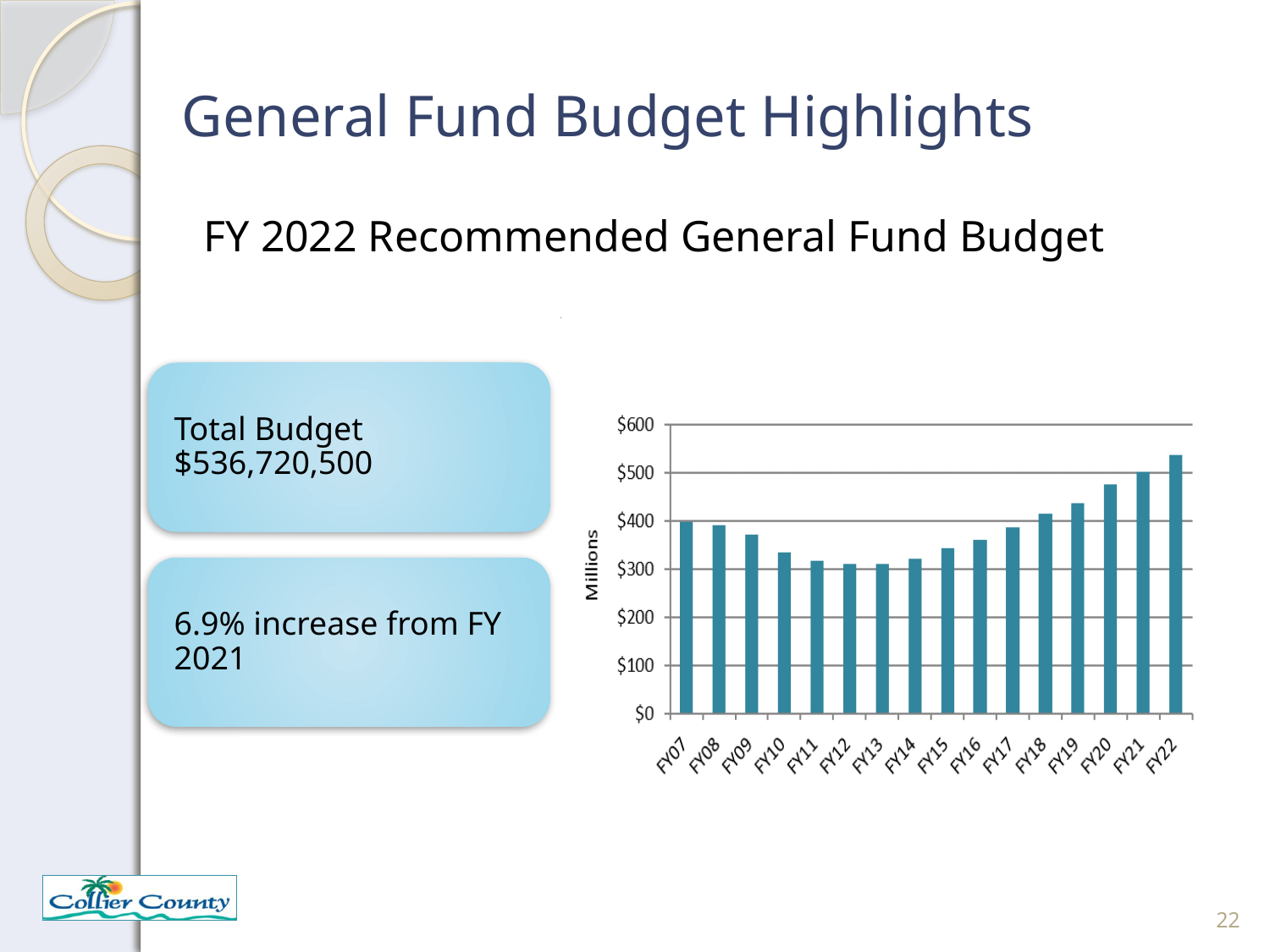
What is the label on the vertical axis of the chart? Millions Which is larger, the value for FY09 or the value for FY15? FY09 Which is larger, the value for FY07 or the value for FY22? FY22 Do the values rise or fall from FY13 to FY22? rise Which fiscal year has the highest bar on the chart? FY22 Is the value for FY20 greater or less than $400? greater What kind of chart is shown on the slide? bar chart Is the value for FY10 greater or less than $400? less How many fiscal years are plotted on the chart? 16 Is the value for FY12 greater or less than $400? less